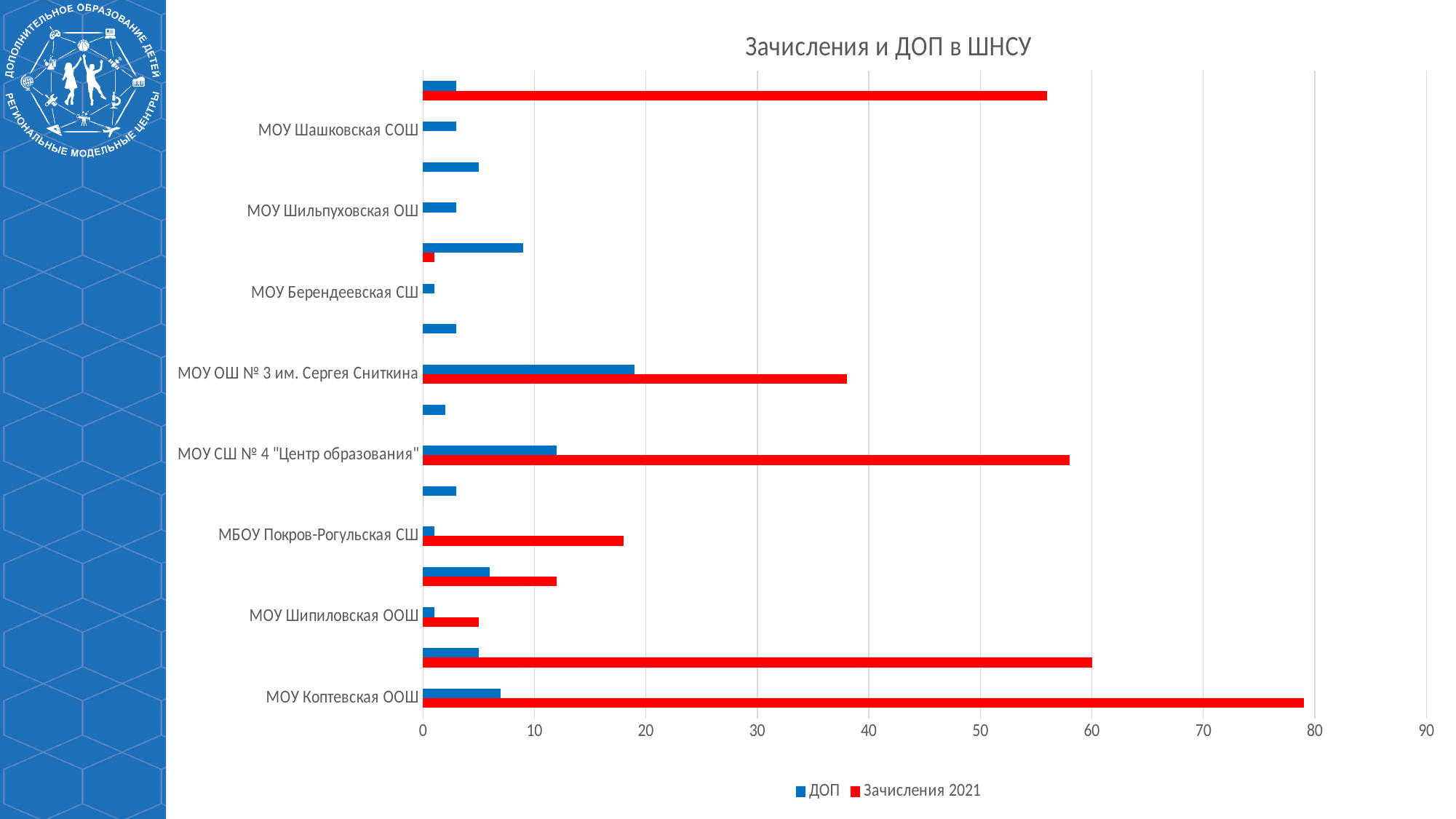
Is the Зачисления 2021 value for МОУ ОШ № 3 им. Сергея Сниткина greater or less than 30? greater How many series does the legend list? 2 Which school has the highest value for ДОП? МОУ ОШ № 3 им. Сергея Сниткина Is the Зачисления 2021 value for МБОУ Покров-Рогульская СШ greater or less than 10? greater Is the ДОП value for МОУ Шипиловская ООШ greater or less than 10? less Which is larger for МОУ Коптевская ООШ: the ДОП value or the Зачисления 2021 value? Зачисления 2021 Which series is shown in red? Зачисления 2021 What is the title of the chart? Зачисления и ДОП в ШНСУ What kind of chart is shown on the slide? bar chart Which school has the highest value for Зачисления 2021? МОУ Коптевская ООШ